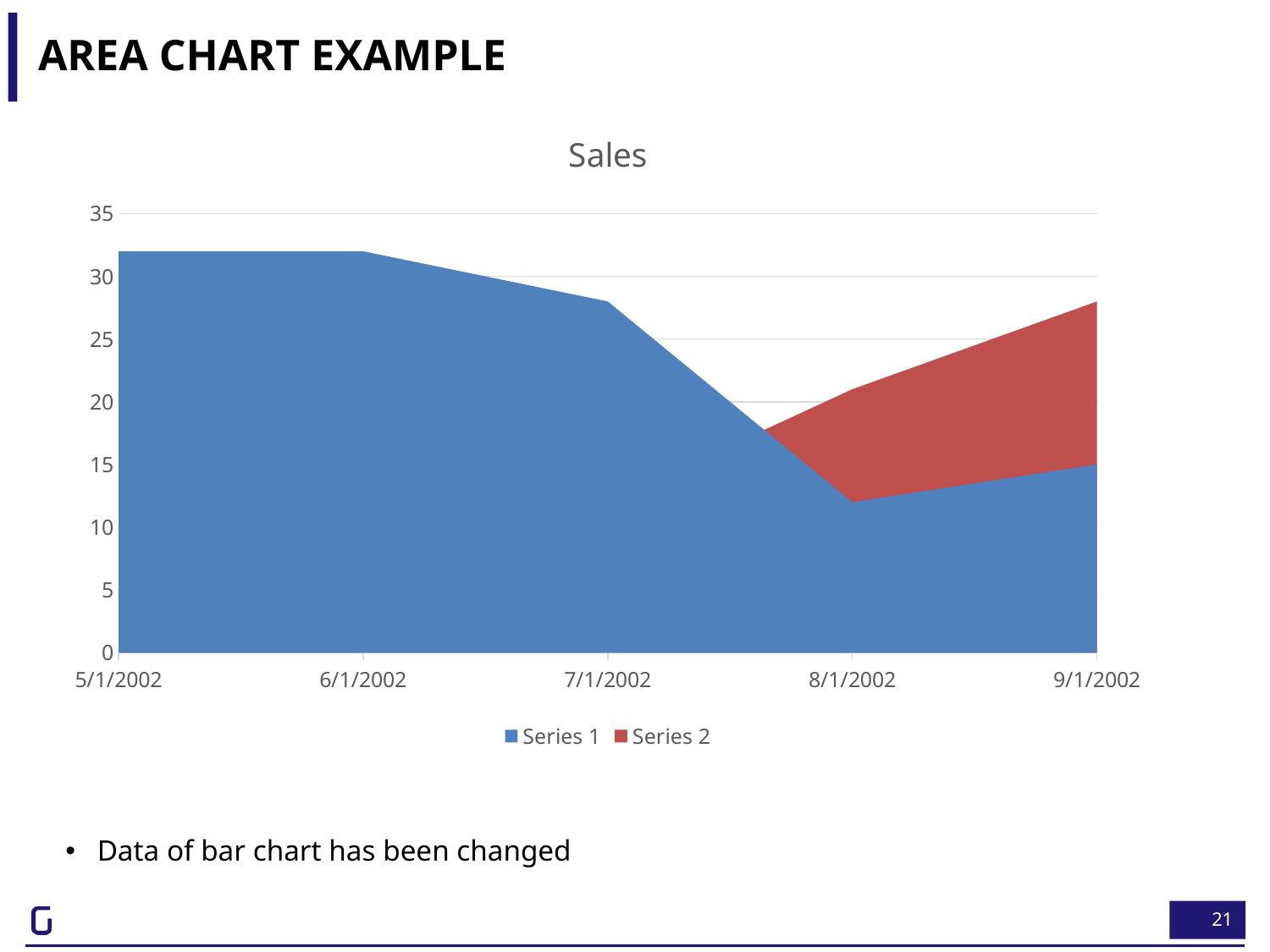
At which date is Series 1 at its lowest? 8/1/2002 Is the value for Series 1 at 7/1/2002 greater or less than 25? greater How many series does the legend list? 2 What kind of chart is shown on the slide? Area chart How many dates are shown along the x axis? 5 Is the value for Series 1 at 8/1/2002 greater or less than 15? less Which is larger for Series 1: the value at 5/1/2002 or the value at 8/1/2002? 5/1/2002 Does Series 1 rise or fall from 5/1/2002 to 8/1/2002? Fall What is the title of the chart? Sales Is the value for Series 1 at 5/1/2002 greater or less than 30? greater At 9/1/2002, which series has the larger value, Series 1 or Series 2? Series 2